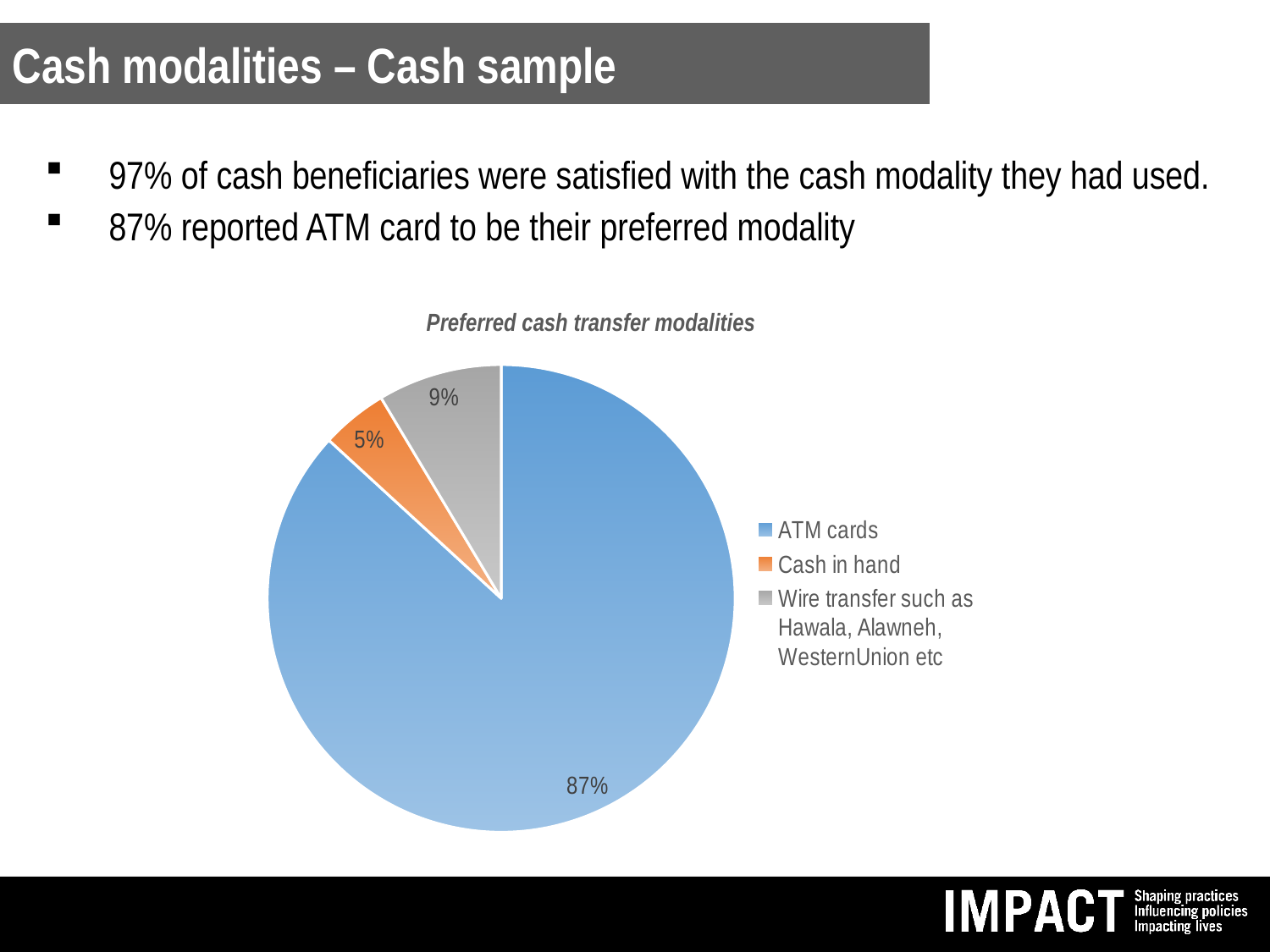
How many slices does the pie chart have? 3 Which category has the smallest slice of the pie? Cash in hand What share of the pie is Wire transfer such as Hawala, Alawneh, WesternUnion etc? 9% What share of the pie is Cash in hand? 5% What is the difference in percentage points between the Wire transfer slice and the Cash in hand slice? 4 Which category has the largest slice of the pie? ATM cards What is the title of the chart? Preferred cash transfer modalities Which is larger, the Cash in hand slice or the Wire transfer slice? Wire transfer What share of the pie is ATM cards? 87% What colour is the Cash in hand slice? Orange What kind of chart is shown on the slide? Pie chart What is the difference in percentage points between the ATM cards slice and the Wire transfer slice? 78